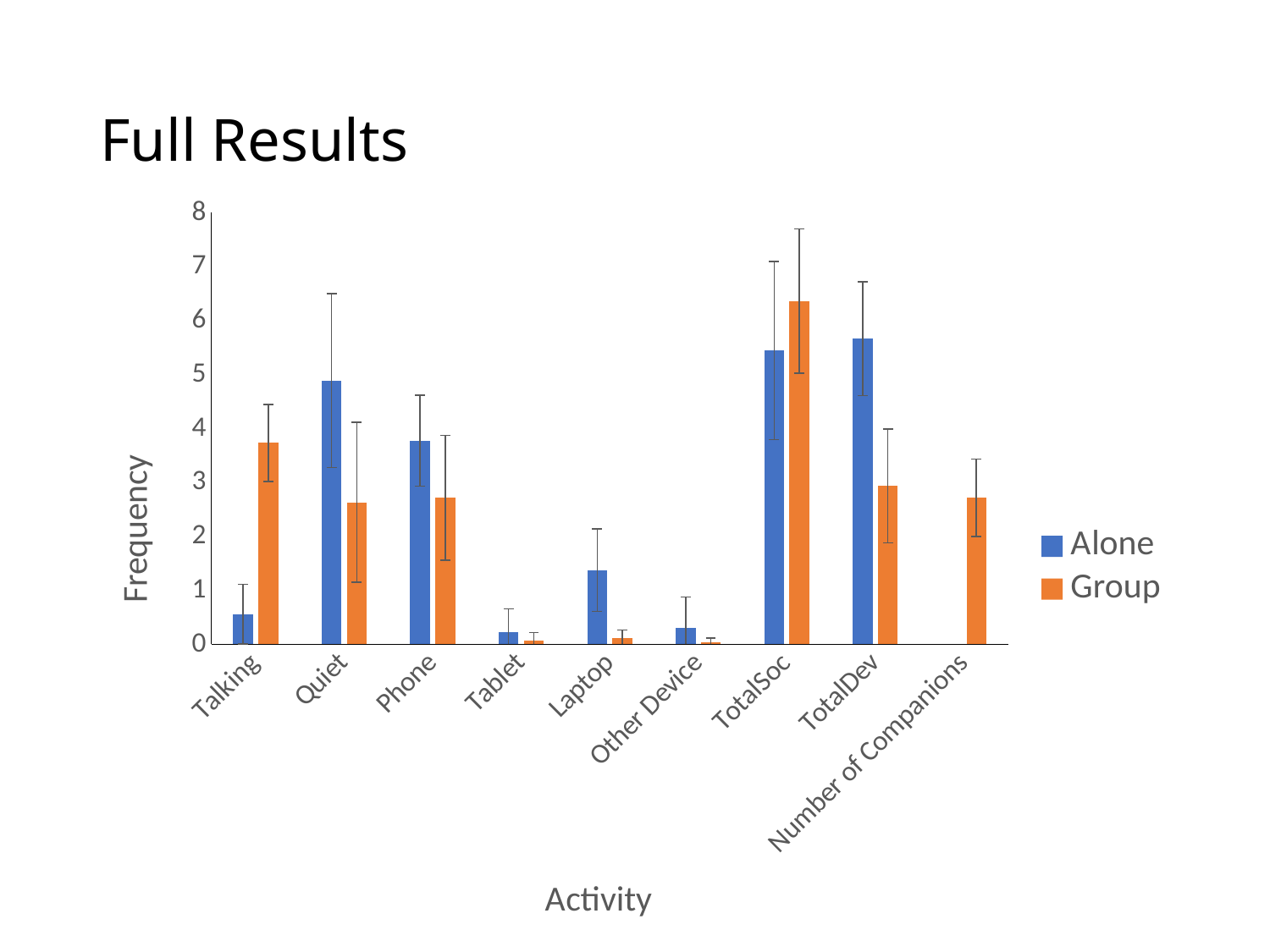
Is the Alone value for Quiet greater or less than 4? greater Is the Group value for Talking greater or less than 3? greater How many activity categories are shown on the x axis? 9 What is the label of the y axis? Frequency What kind of chart is shown on the slide? bar chart Which category has the highest Group value? TotalSoc For Talking, which series has the larger value, Alone or Group? Group Is the Group value for TotalDev greater or less than 4? less For Quiet, which series has the larger value, Alone or Group? Alone How many series does the legend list? 2